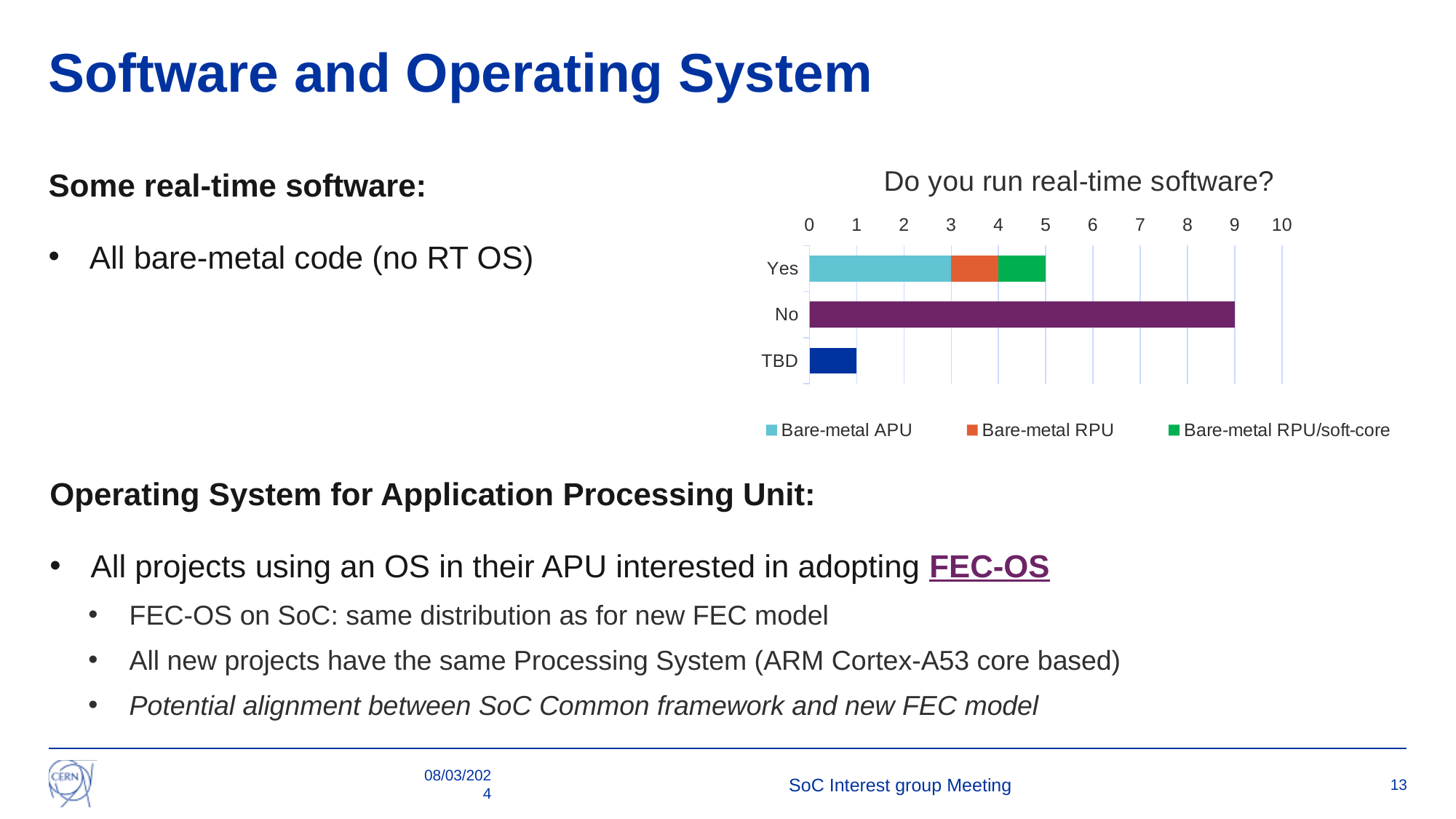
What is the total of the stacked bar for 'Yes' in the chart? 5 How many categories are shown on the vertical axis of the chart? 3 What kind of chart is shown on the slide? bar chart What is the Bare-metal APU value for 'Yes' in the chart? 3 Which category has the shortest bar in the chart? TBD Which is larger in the chart, the bar for 'Yes' or the bar for 'No'? No What is the value of the bar for 'TBD' in the chart? 1 What is the title of the chart on the slide? Do you run real-time software? Which category has the longest bar in the chart? No What is the value of the bar for 'No' in the chart? 9 How many series does the chart's legend list? 3 Is the bar for 'No' greater or less than 8? greater